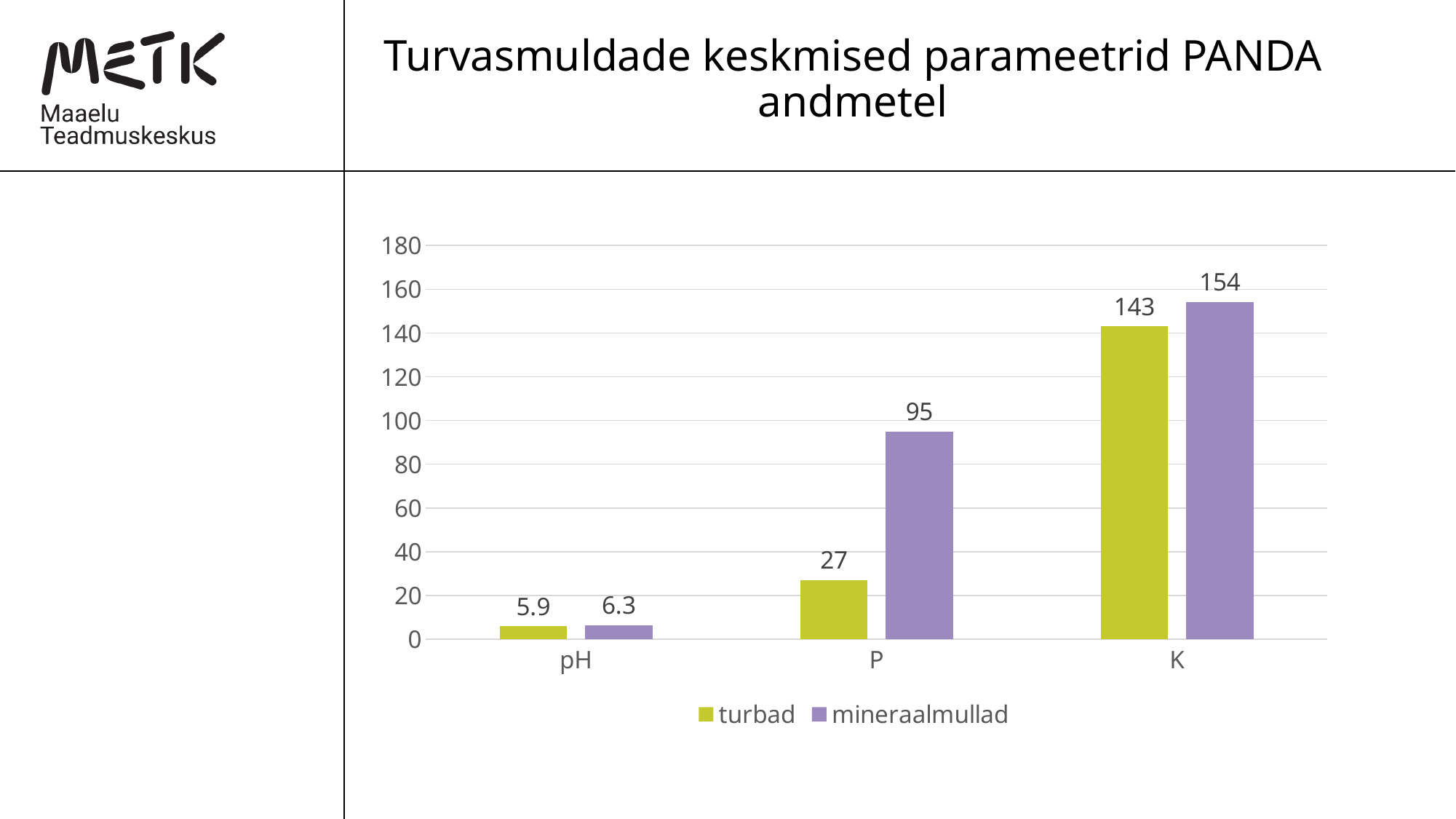
What is the value for turbad at K? 143 What is the value for mineraalmullad at pH? 6.3 What is the value for mineraalmullad at P? 95 What is the difference between mineraalmullad and turbad at K? 11 Which category has the highest value for mineraalmullad? K Which is larger at P: turbad or mineraalmullad? mineraalmullad What kind of chart is shown on the slide? bar chart Which category has the lowest value for turbad? pH How many categories are shown on the x axis? 3 What is the value for turbad at pH? 5.9 What is the difference between mineraalmullad and turbad at P? 68 How many series does the legend list? 2